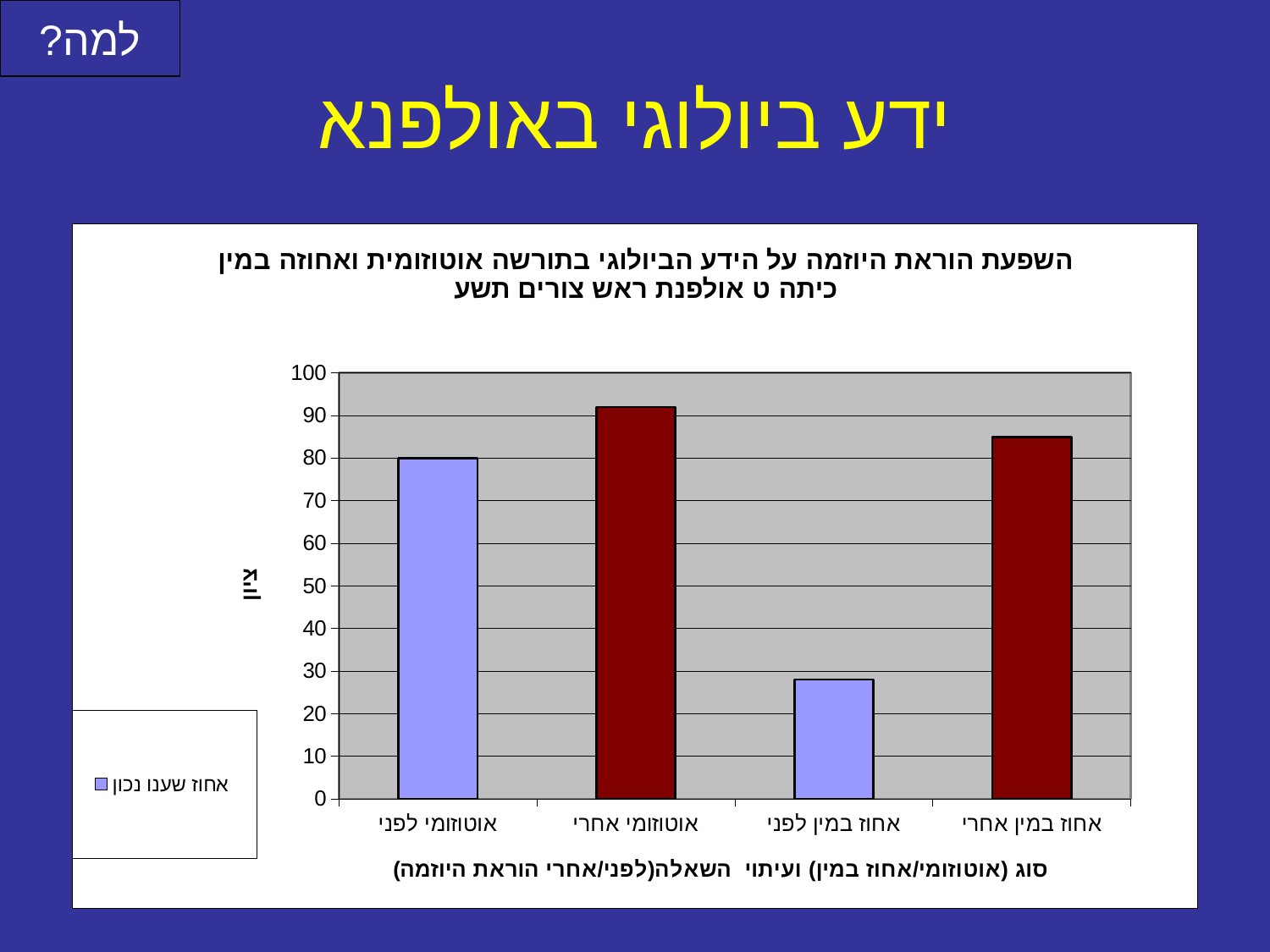
How many categories are shown on the x axis of the chart? 4 Is the value for אחוז במין אחרי greater or less than 80? greater Which category has the lowest bar in the chart? אחוז במין לפני Which category has the highest bar in the chart? אוטוזומי אחרי Which is larger, the value for אחוז במין לפני or the value for אחוז במין אחרי? אחוז במין אחרי What kind of chart is shown on the slide? bar chart Is the value for אחוז במין לפני greater or less than 30? less What is the legend entry shown for the chart? אחוז שענו נכון Is the value for אוטוזומי אחרי greater or less than 90? greater Which is larger, the value for אוטוזומי לפני or the value for אוטוזומי אחרי? אוטוזומי אחרי How many series does the chart's legend list? 1 What is the title of the chart's vertical axis? ציון